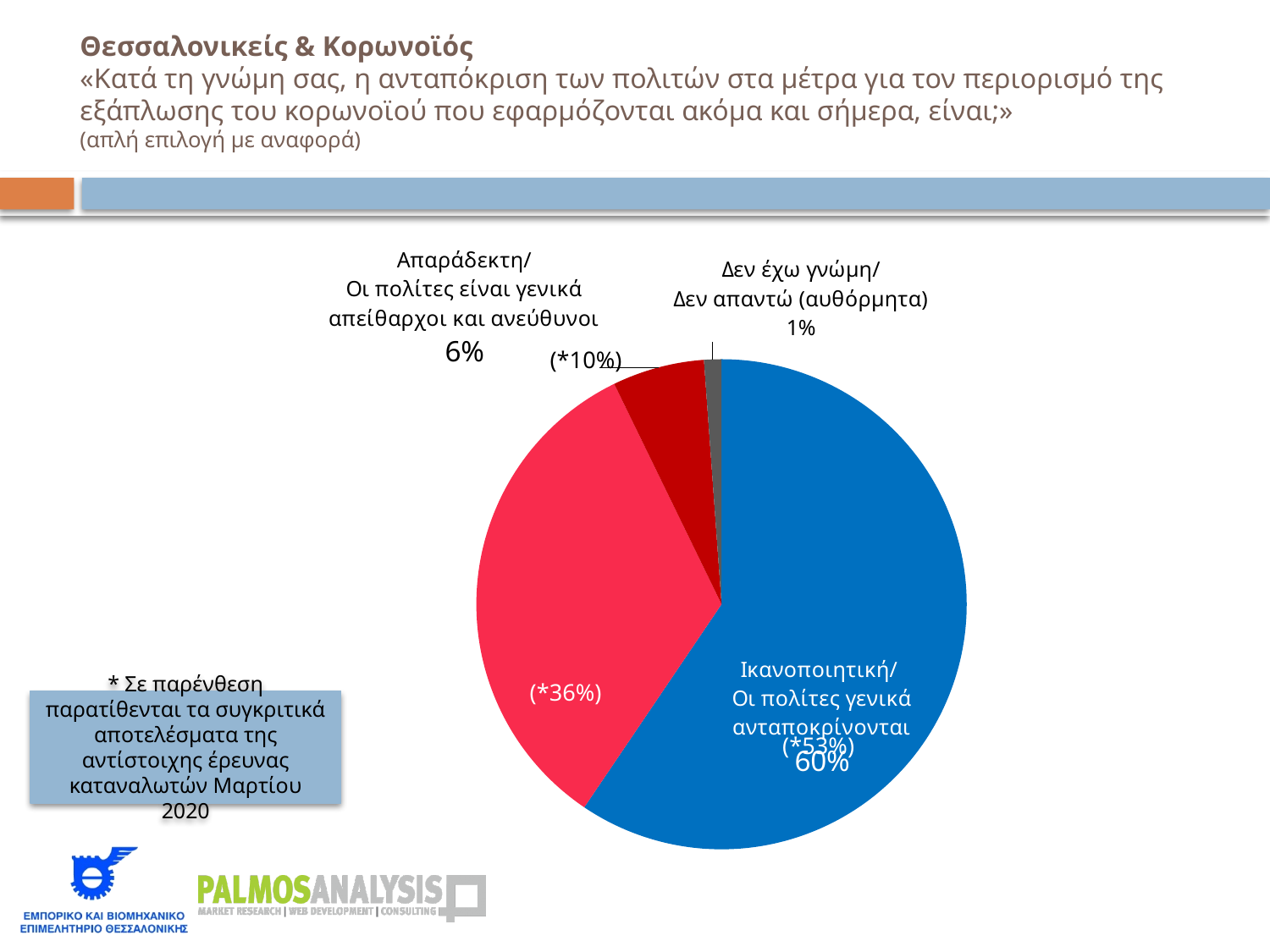
Which is larger: the share for «Απαράδεκτη» or the share for «Δεν έχω γνώμη/Δεν απαντώ»? Απαράδεκτη How many slices does the pie chart have? 4 What was the March 2020 comparative value shown in parentheses for «Απαράδεκτη/Οι πολίτες είναι γενικά απείθαρχοι και ανεύθυνοι»? 10% What percentage of respondents answered «Δεν έχω γνώμη/Δεν απαντώ (αυθόρμητα)»? 1% What was the March 2020 comparative value shown in parentheses for «Ικανοποιητική/Οι πολίτες γενικά ανταποκρίνονται»? 53% By how many percentage points did the «Ικανοποιητική» share change from the March 2020 value (53%) to the current value (60%)? 7 percentage points What percentage of respondents answered «Ικανοποιητική/Οι πολίτες γενικά ανταποκρίνονται»? 60% What type of chart is shown on the slide? Pie chart Which answer has the largest share of the pie? Ικανοποιητική/Οι πολίτες γενικά ανταποκρίνονται Which answer has the smallest share of the pie? Δεν έχω γνώμη/Δεν απαντώ (αυθόρμητα) What is the difference in percentage points between «Ικανοποιητική» (60%) and «Απαράδεκτη» (6%)? 54 percentage points What percentage of respondents answered «Απαράδεκτη/Οι πολίτες είναι γενικά απείθαρχοι και ανεύθυνοι»? 6%